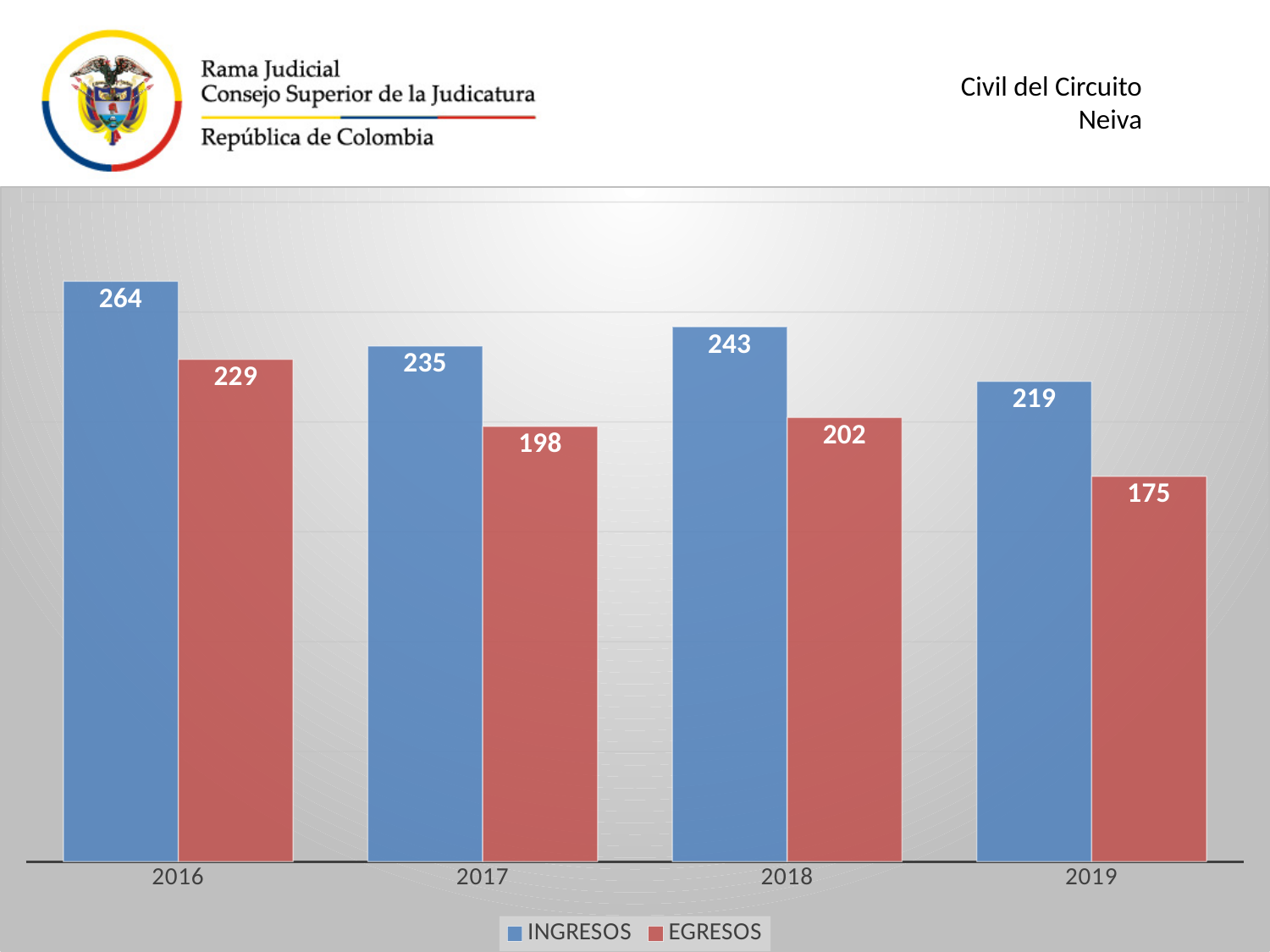
How many years are shown on the x axis? 4 Which is larger, EGRESOS in 2016 or INGRESOS in 2019? EGRESOS in 2016 What is the EGRESOS value for 2017? 198 What is the EGRESOS value for 2019? 175 What is the difference between the INGRESOS values for 2016 and 2019? 45 What is the difference between INGRESOS and EGRESOS in 2018? 41 Which colour represents the EGRESOS series? Red Which year has the lowest EGRESOS value? 2019 How many series does the legend list? 2 Which year has the highest INGRESOS value? 2016 What is the INGRESOS value for 2016? 264 What kind of chart is shown on the slide? Bar chart